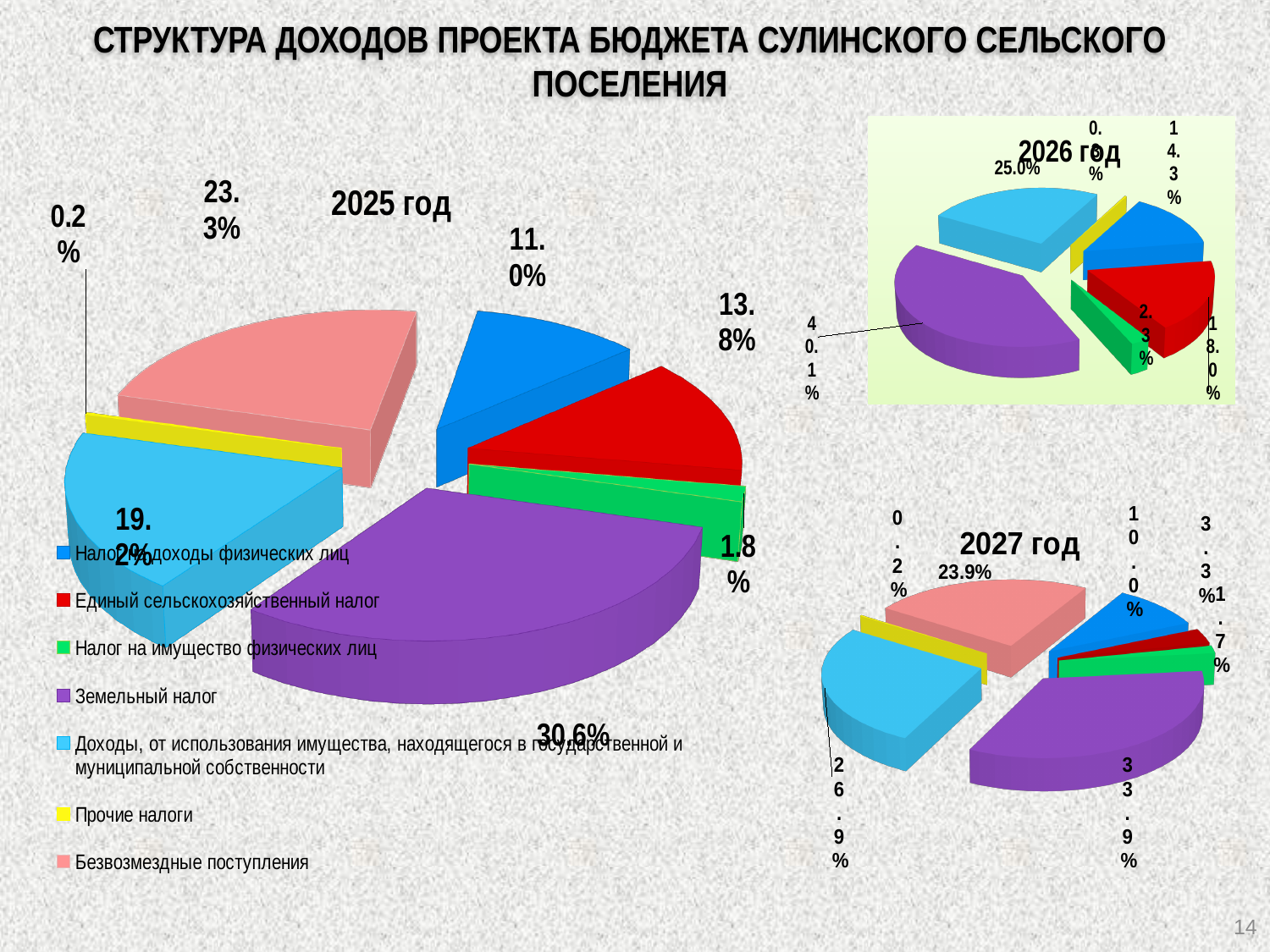
In the 2025 год chart, what is the difference between the shares of Земельный налог and Безвозмездные поступления? 7.3% In the 2025 год chart, which is larger: Налог на доходы физических лиц or Единый сельскохозяйственный налог? Единый сельскохозяйственный налог In the 2027 год chart, what share does Безвозмездные поступления have? 23.9% In the 2026 год chart, what share does Земельный налог have? 40.1% In the 2025 год chart, what share does Единый сельскохозяйственный налог have? 13.8% In the 2025 год chart, which category has the largest share? Земельный налог How many entries does the legend list? 7 In the 2025 год chart, what share does Земельный налог have? 30.6% In the 2027 год chart, what share does Земельный налог have? 33.9% In the 2026 год chart, what share does Доходы, от использования имущества, находящегося в государственной и муниципальной собственности have? 25.0% In the 2025 год chart, what share does Безвозмездные поступления have? 23.3% In the 2025 год chart, which category has the smallest share? Прочие налоги